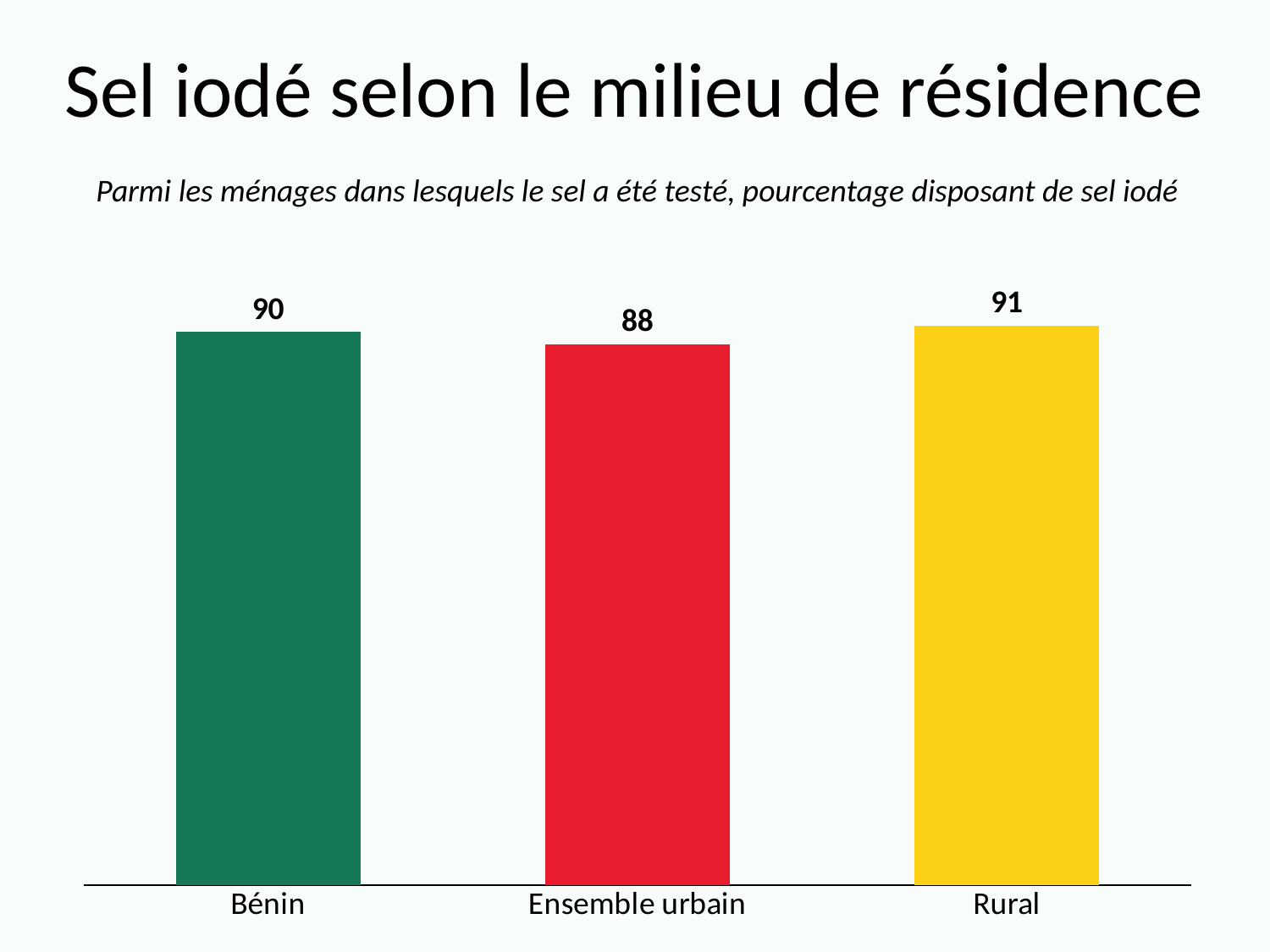
Which is larger, the value for Rural or the value for Ensemble urbain? Rural What kind of chart is shown on the slide? Bar chart What is the title of the chart? Sel iodé selon le milieu de résidence How many categories are shown on the chart? 3 What is the value for Rural? 91 What is the value for Bénin? 90 Which category has the lowest value? Ensemble urbain What is the difference between the values for Bénin and Ensemble urbain? 2 What colour is the bar for Ensemble urbain? Red What is the value for Ensemble urbain? 88 Which category has the highest value? Rural What is the difference between the values for Rural and Ensemble urbain? 3